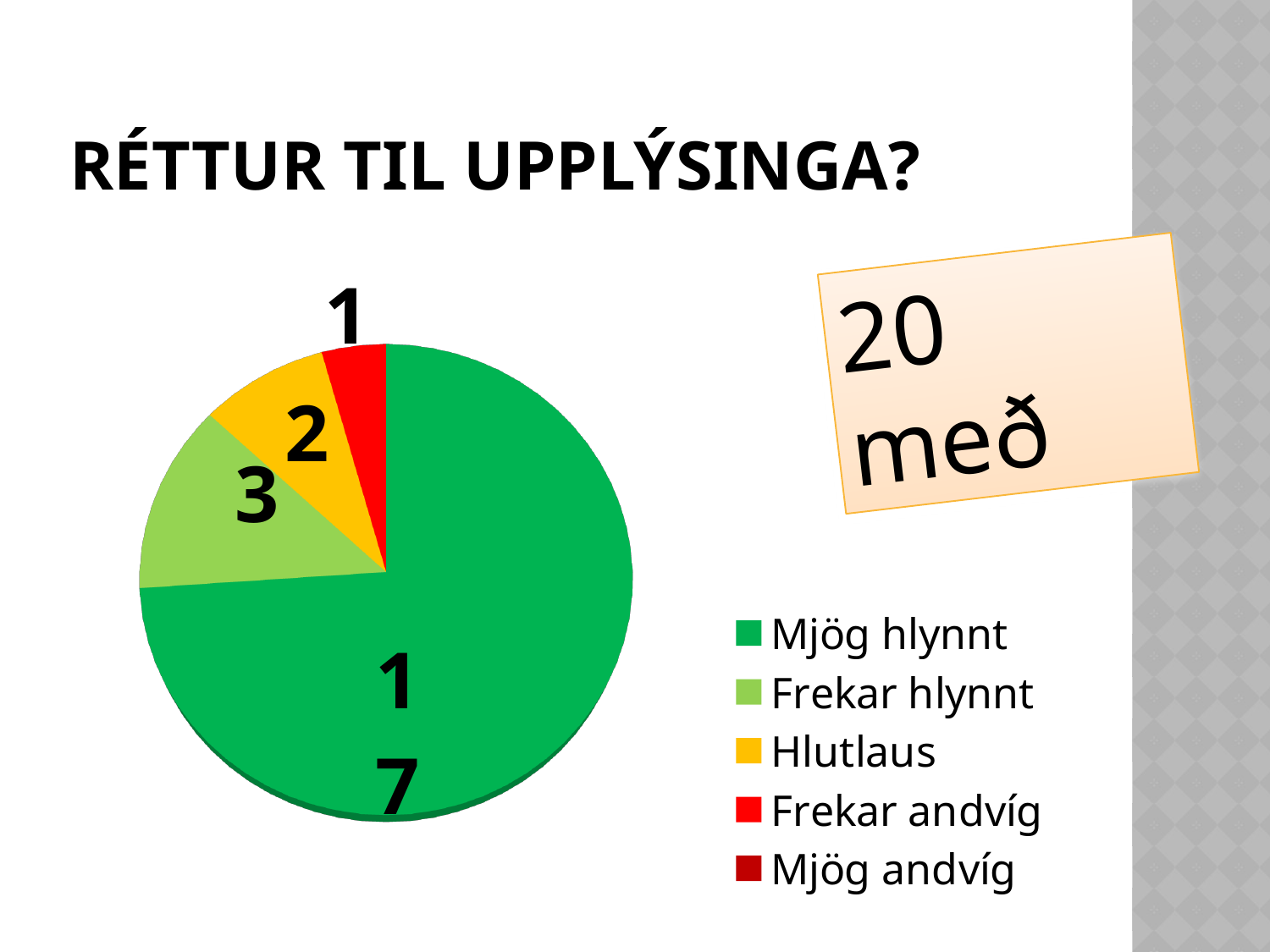
What is the value for Frekar andvíg in the pie chart? 1 What is the difference between the values for Frekar hlynnt and Hlutlaus? 1 Which labelled slice of the pie chart has the smallest value? Frekar andvíg Which is larger, the value for Hlutlaus or the value for Frekar andvíg? Hlutlaus What type of chart is shown on the slide? pie chart What is the value for Frekar hlynnt in the pie chart? 3 What is the value for Mjög hlynnt in the pie chart? 17 How many entries does the legend of the pie chart list? 5 What is the difference between the values for Mjög hlynnt and Frekar hlynnt? 14 What is the value for Hlutlaus in the pie chart? 2 What colour is the Mjög hlynnt slice in the pie chart? green Which category has the largest slice of the pie chart? Mjög hlynnt